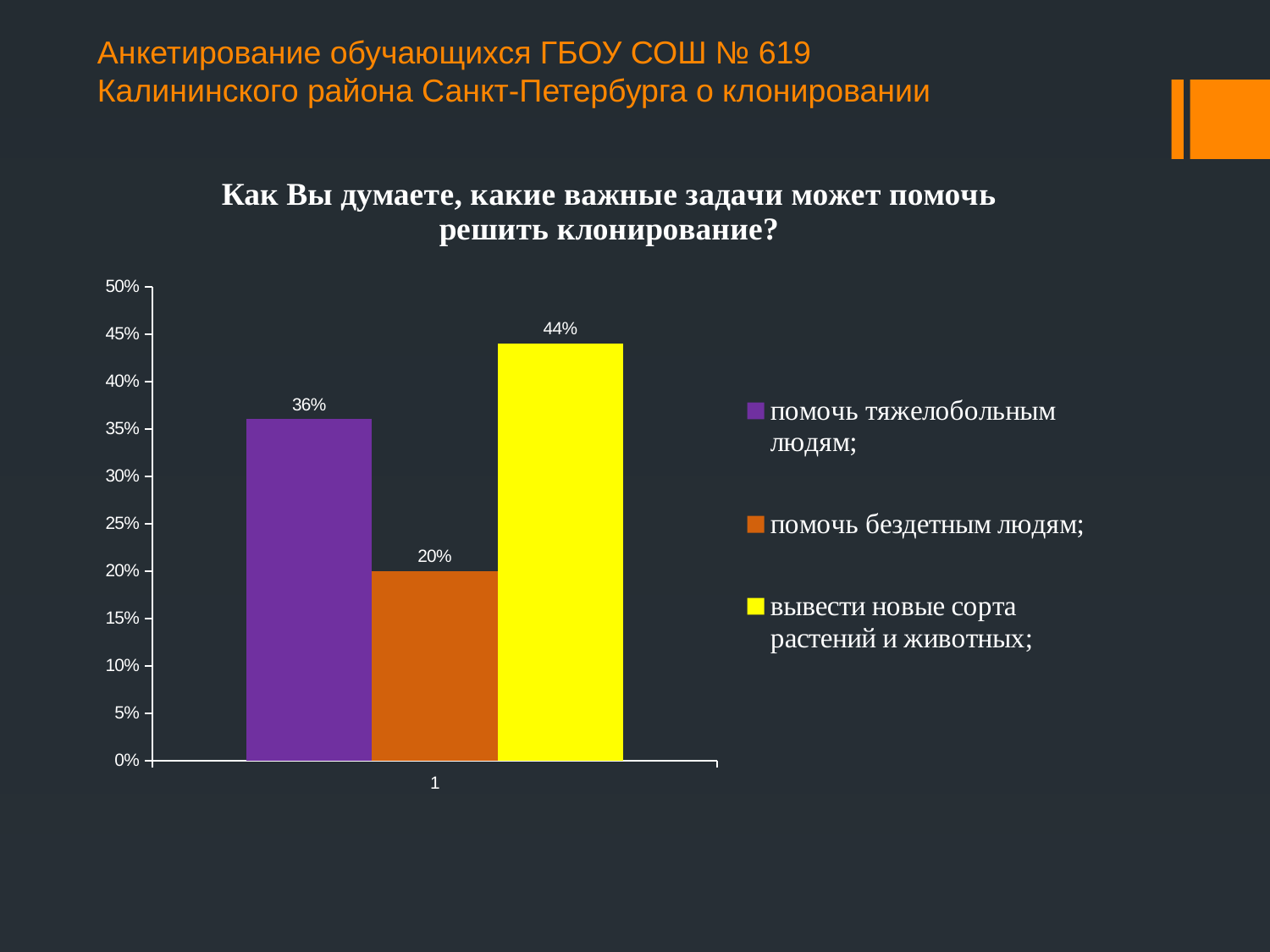
What is the value for "вывести новые сорта растений и животных"? 44% What is the value for "помочь тяжелобольным людям"? 36% Which series has the highest value? вывести новые сорта растений и животных Which series has the lowest value? помочь бездетным людям Which is larger: the value for "помочь тяжелобольным людям" or for "помочь бездетным людям"? помочь тяжелобольным людям Is the value for "вывести новые сорта растений и животных" greater or less than 40%? greater What is the value for "помочь бездетным людям"? 20% What colour is the bar for "помочь бездетным людям"? orange How many series does the legend list? 3 What is the difference between the values for "помочь тяжелобольным людям" and "помочь бездетным людям"? 16% What is the difference between the values for "вывести новые сорта растений и животных" and "помочь тяжелобольным людям"? 8% What kind of chart is shown on the slide? bar chart